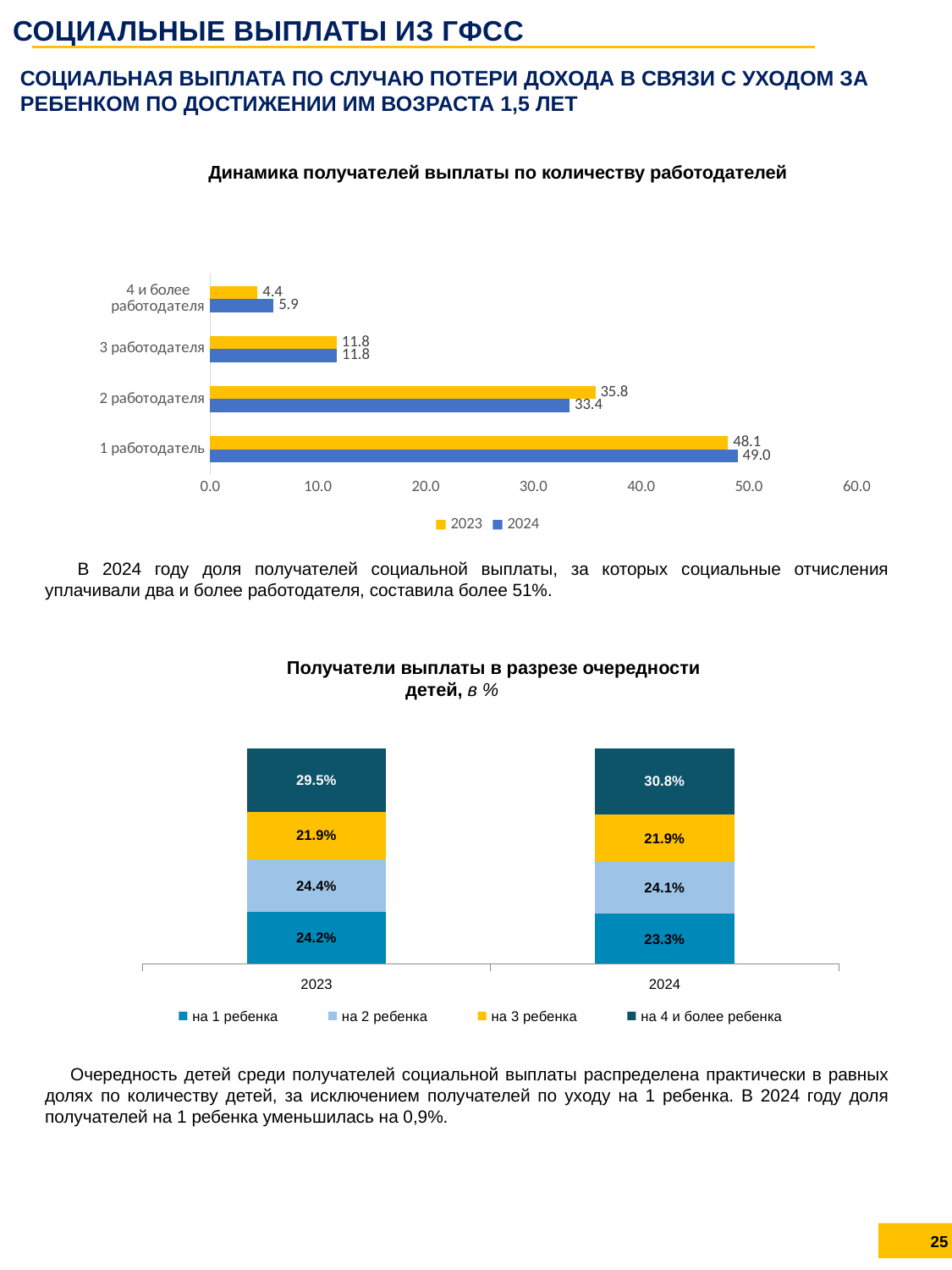
What type of chart is 'Динамика получателей выплаты по количеству работодателей'? bar chart In the chart 'Динамика получателей выплаты по количеству работодателей', which category has the lowest 2023 value? 4 и более работодателя In the chart 'Динамика получателей выплаты по количеству работодателей', what is the difference between the 2023 and 2024 values for '2 работодателя'? 2.4 In the chart 'Динамика получателей выплаты по количеству работодателей', what is the 2023 value for '2 работодателя'? 35.8 In the chart 'Получатели выплаты в разрезе очередности детей, в %', how many categories does the legend list? 4 In the chart 'Получатели выплаты в разрезе очередности детей, в %', what is the share for 'на 1 ребенка' in 2023? 24.2% In the chart 'Динамика получателей выплаты по количеству работодателей', how many series does the legend list? 2 In the chart 'Динамика получателей выплаты по количеству работодателей', what is the 2024 value for '4 и более работодателя'? 5.9 In the chart 'Динамика получателей выплаты по количеству работодателей', which category has the highest 2024 value? 1 работодатель In the chart 'Получатели выплаты в разрезе очередности детей, в %', what is the share for 'на 4 и более ребенка' in 2024? 30.8% In the chart 'Получатели выплаты в разрезе очередности детей, в %', what is the difference between the 'на 1 ребенка' shares in 2023 and 2024? 0.9% In the chart 'Динамика получателей выплаты по количеству работодателей', is the 2024 value for '1 работодатель' larger or smaller than the 2023 value? larger